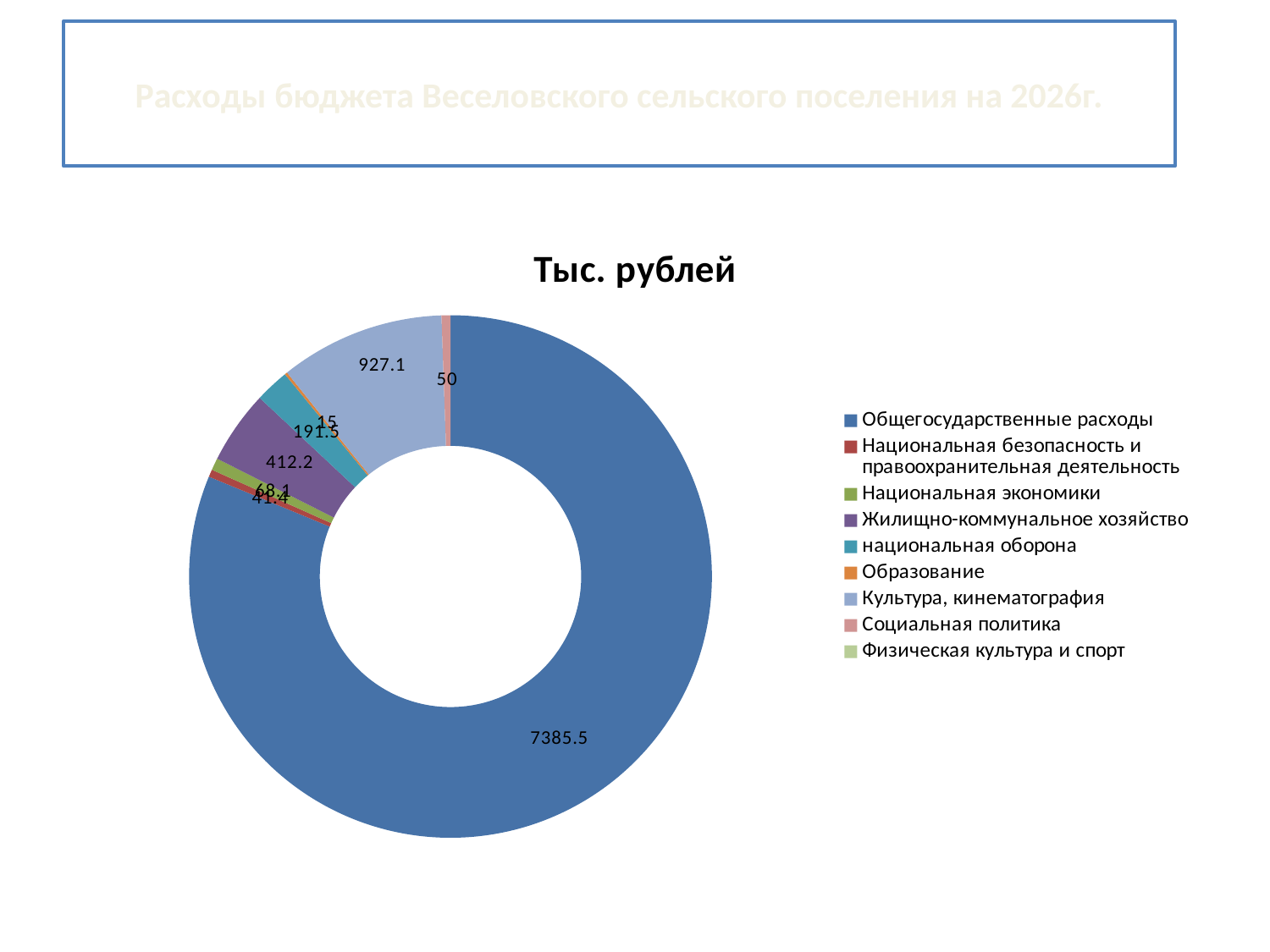
What is the title of the chart? Тыс. рублей What is the value for Социальная политика? 50 What is the value for Образование? 15 What is the value for Жилищно-коммунальное хозяйство? 412.2 Which category has the largest value? Общегосударственные расходы Which is larger: Культура, кинематография or Жилищно-коммунальное хозяйство? Культура, кинематография What is the value for национальная оборона? 191.5 What is the value for Общегосударственные расходы? 7385.5 What is the difference between Культура, кинематография and Жилищно-коммунальное хозяйство? 514.9 How many categories does the legend list? 9 What is the value for Культура, кинематография? 927.1 What kind of chart is shown on the slide? doughnut chart